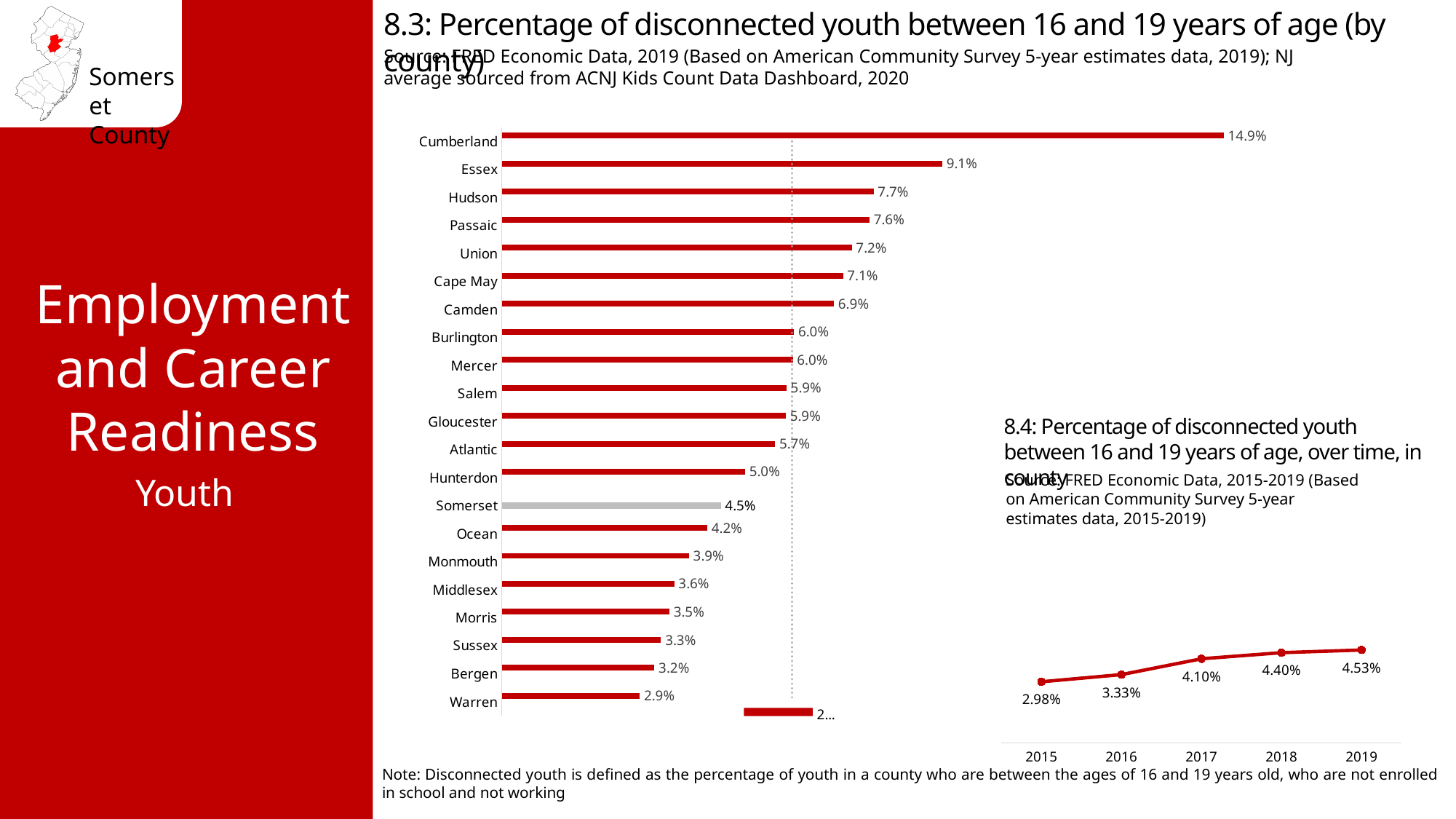
In chart 8.3 (percentage of disconnected youth by county), which is larger, the value for Hudson or the value for Camden? Hudson In chart 8.3 (percentage of disconnected youth by county), which county has the highest value? Cumberland In chart 8.4 (percentage of disconnected youth over time in Somerset County), do the values rise or fall from 2015 to 2019? Rise In chart 8.3 (percentage of disconnected youth by county), what is the value for Essex? 9.1% In chart 8.4 (percentage of disconnected youth over time in Somerset County), what is the value for 2017? 4.10% In chart 8.3 (percentage of disconnected youth by county), which county's bar is shown in grey instead of red? Somerset In chart 8.4 (percentage of disconnected youth over time in Somerset County), how many years are plotted? 5 In chart 8.3 (percentage of disconnected youth by county), what is the difference between Cumberland and Essex? 5.8% In chart 8.4 (percentage of disconnected youth over time in Somerset County), what is the difference between the 2019 and 2015 values? 1.55% In chart 8.3 (percentage of disconnected youth by county), which county has the lowest value? Warren In chart 8.3 (percentage of disconnected youth by county), what is the value for Somerset? 4.5% In chart 8.3 (percentage of disconnected youth by county), what kind of chart is used? Bar chart